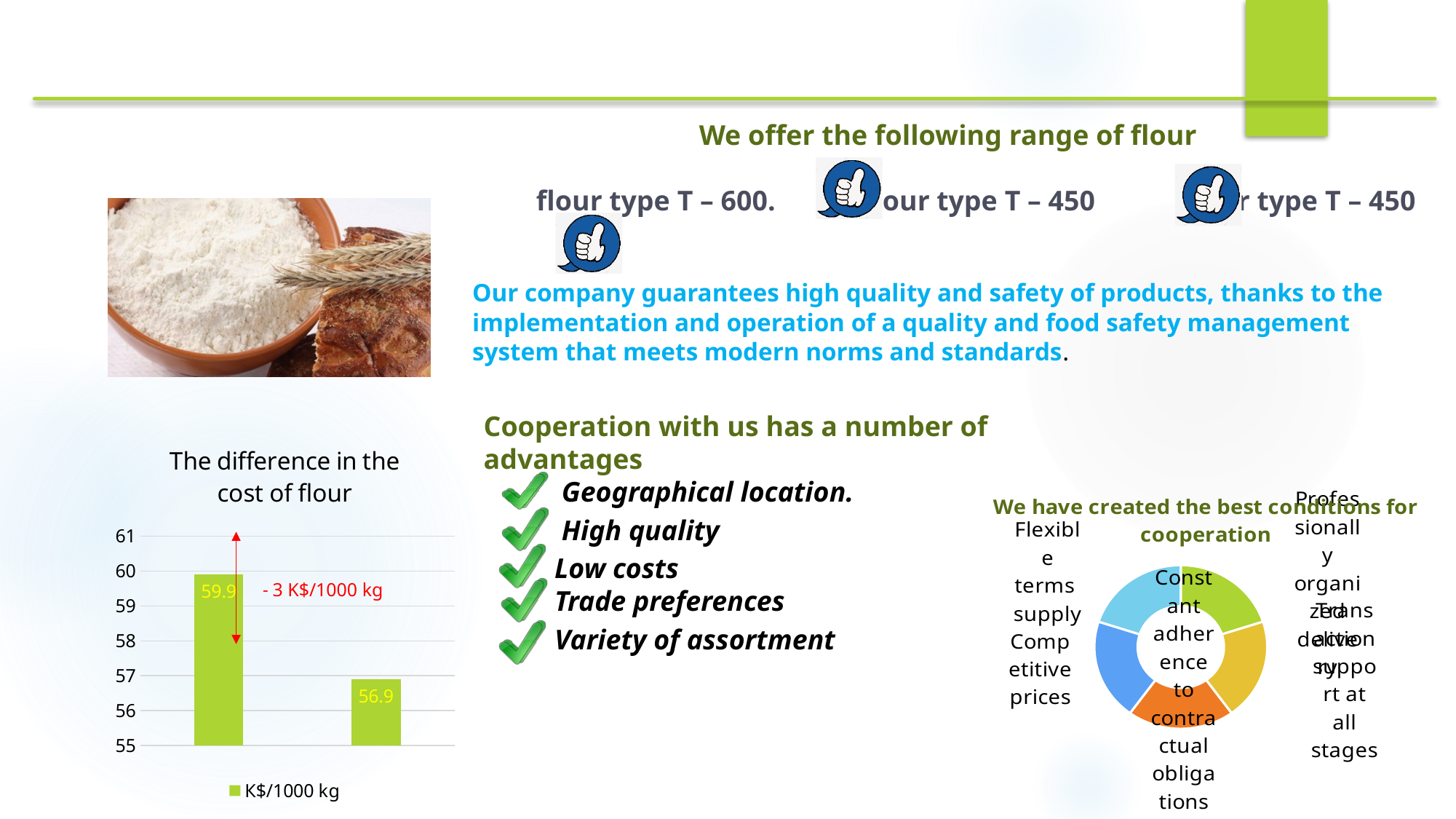
In the chart titled 'The difference in the cost of flour', is the value of the right bar greater or less than 57? less What is the difference annotated in red next to the bars in the chart titled 'The difference in the cost of flour'? - 3 K$/1000 kg How many bars are plotted in the chart titled 'The difference in the cost of flour'? 2 What is the legend entry shown below the chart titled 'The difference in the cost of flour'? K$/1000 kg In the chart titled 'The difference in the cost of flour', what is the value of the right bar? 56.9 In the chart titled 'The difference in the cost of flour', what is the difference between the two bars? 3 In the chart titled 'The difference in the cost of flour', which bar is taller, the left or the right? left In the chart titled 'The difference in the cost of flour', what is the value of the left bar? 59.9 What type of chart is 'The difference in the cost of flour'? bar chart What type of chart is shown under the heading 'We have created the best conditions for cooperation' at the bottom right of the slide? doughnut chart In the chart titled 'The difference in the cost of flour', is the value of the left bar greater or less than 59? greater How many segments does the doughnut chart at the bottom right of the slide have? 5